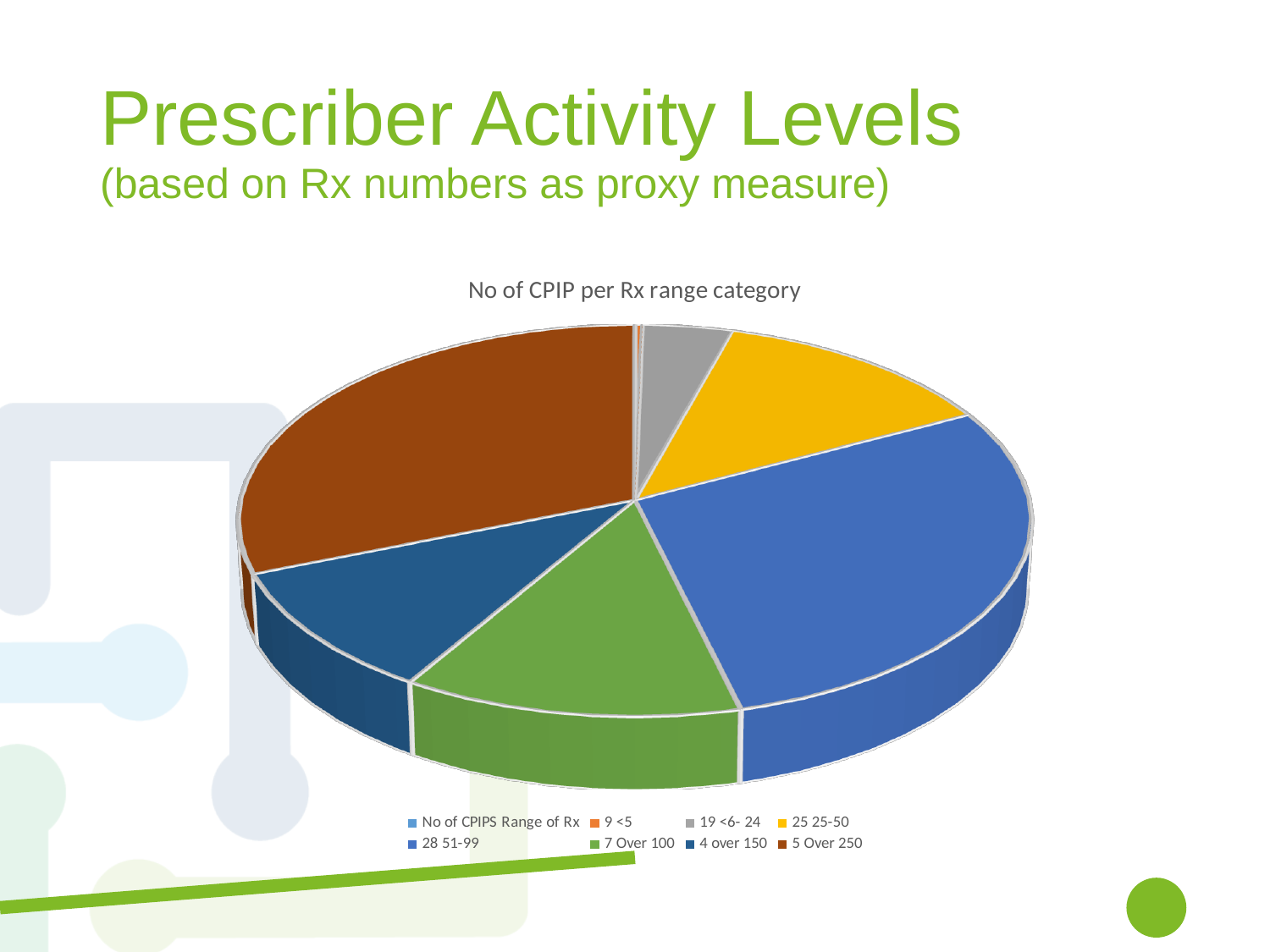
Which legend category has the smallest slice of the pie? 9 <5 What is the title of the chart? No of CPIP per Rx range category Which slice is larger, "5 Over 250" or "25 25-50"? 5 Over 250 How many entries does the chart's legend list? 8 Which slice is larger, "25 25-50" or "19 <6- 24"? 25 25-50 What kind of chart is shown on the slide? pie chart Which legend category has the largest slice of the pie? 5 Over 250 What colour is the slice for "5 Over 250"? brown Which slice is larger, "28 51-99" or "4 over 150"? 28 51-99